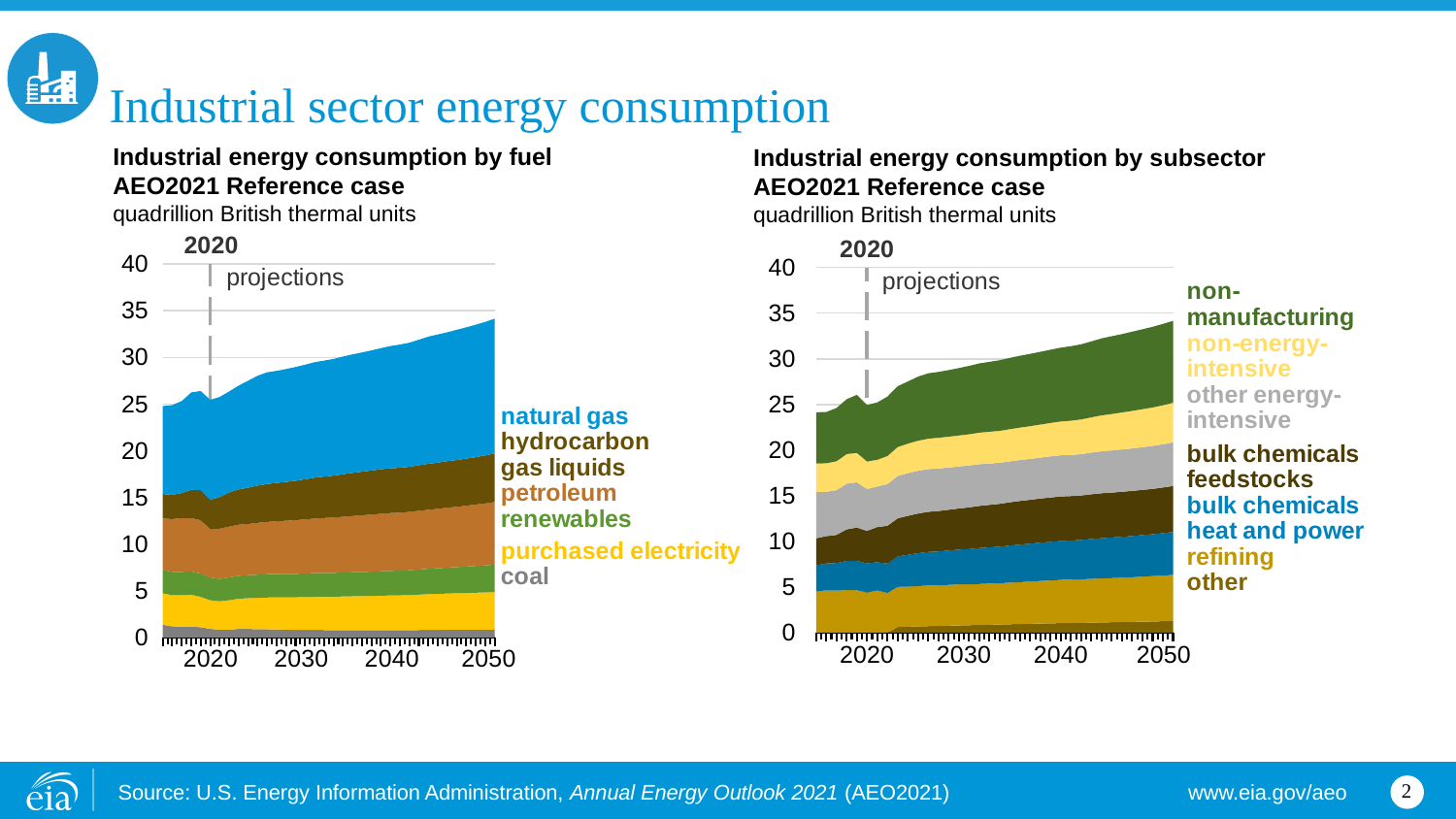
In the left chart, 'Industrial energy consumption by fuel', which fuel accounts for the largest share of consumption? natural gas What unit of measurement is used on the y axis of both charts? quadrillion British thermal units In the right chart, 'Industrial energy consumption by subsector', is total consumption in 2050 greater or less than 30 quadrillion British thermal units? greater What year does the dashed vertical line in each chart mark as the start of the projections? 2020 In the left chart, 'Industrial energy consumption by fuel', which fuel accounts for the smallest share of consumption? coal In the right chart, 'Industrial energy consumption by subsector', which subsector accounts for the largest share of consumption in 2050? non-manufacturing What kind of chart is the 'Industrial energy consumption by fuel' chart on the left? stacked area chart In the left chart, 'Industrial energy consumption by fuel', does total industrial energy consumption rise or fall from 2020 to 2050? rise In the right chart, 'Industrial energy consumption by subsector', which subsector accounts for the smallest share of consumption? other How many subsector series are listed in the legend of the right chart, 'Industrial energy consumption by subsector'? 7 In the left chart, 'Industrial energy consumption by fuel', is total consumption in 2020 greater or less than 30 quadrillion British thermal units? less How many fuel series are listed in the legend of the left chart, 'Industrial energy consumption by fuel'? 6